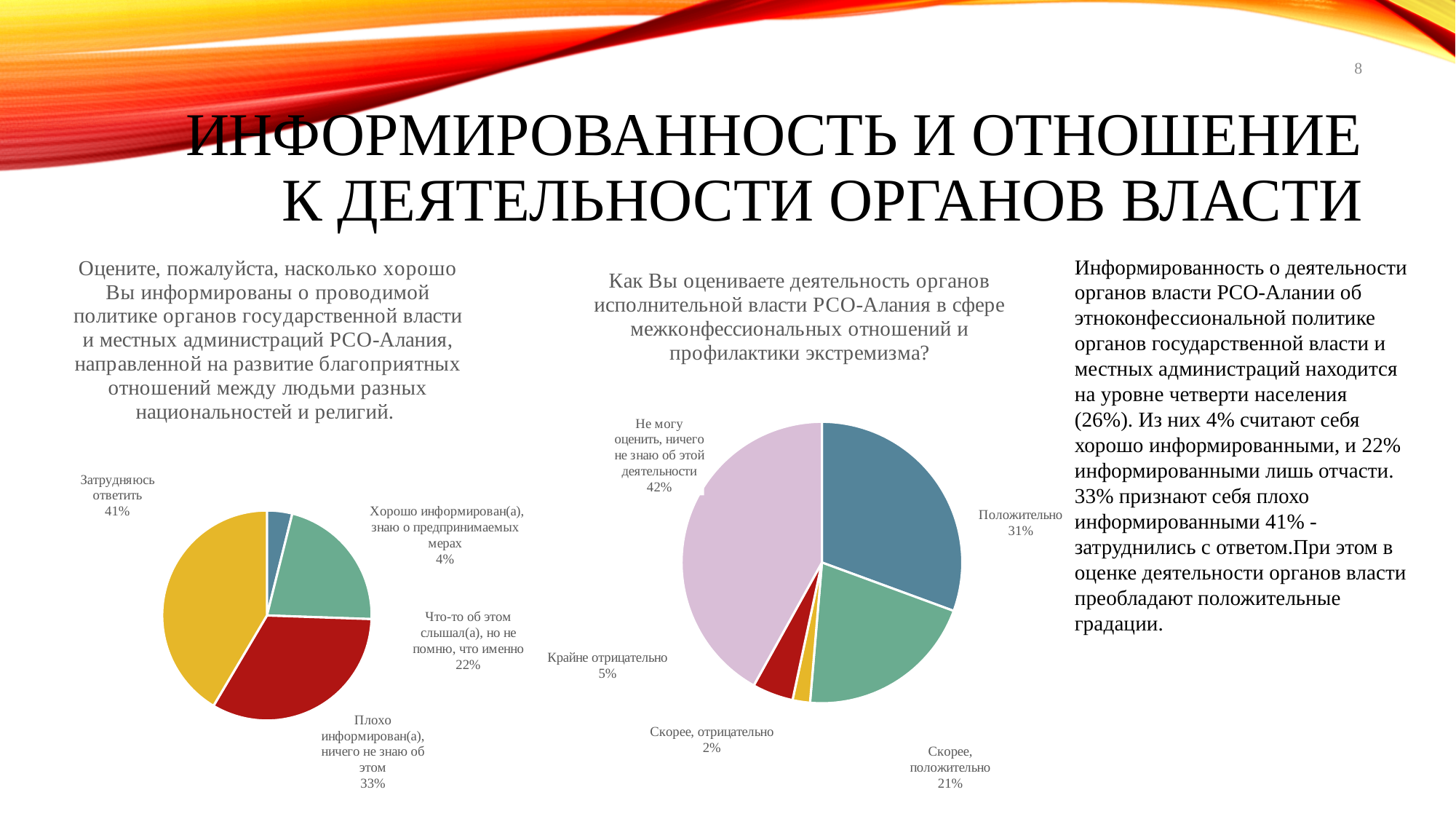
On the right pie chart, what share of respondents answered "Положительно"? 31% What type of chart is used on the right side of the slide? Pie chart On the right pie chart, which category has the largest share? Не могу оценить, ничего не знаю об этой деятельности On the right pie chart, what share answered "Скорее, отрицательно"? 2% On the left pie chart, which category has the largest share? Затрудняюсь ответить On the left pie chart, which category has the smallest share? Хорошо информирован(а), знаю о предпринимаемых мерах How many slices does the left pie chart have? 4 On the left pie chart, what is the difference between "Плохо информирован(а), ничего не знаю об этом" and "Что-то об этом слышал(а), но не помню, что именно"? 11 percentage points How many slices does the right pie chart have? 5 On the left pie chart, what percentage said they are well informed ("Хорошо информирован(а), знаю о предпринимаемых мерах")? 4% On the left pie chart, what share of respondents answered "Затрудняюсь ответить"? 41% On the right pie chart, which is larger: "Крайне отрицательно" or "Скорее, отрицательно"? Крайне отрицательно